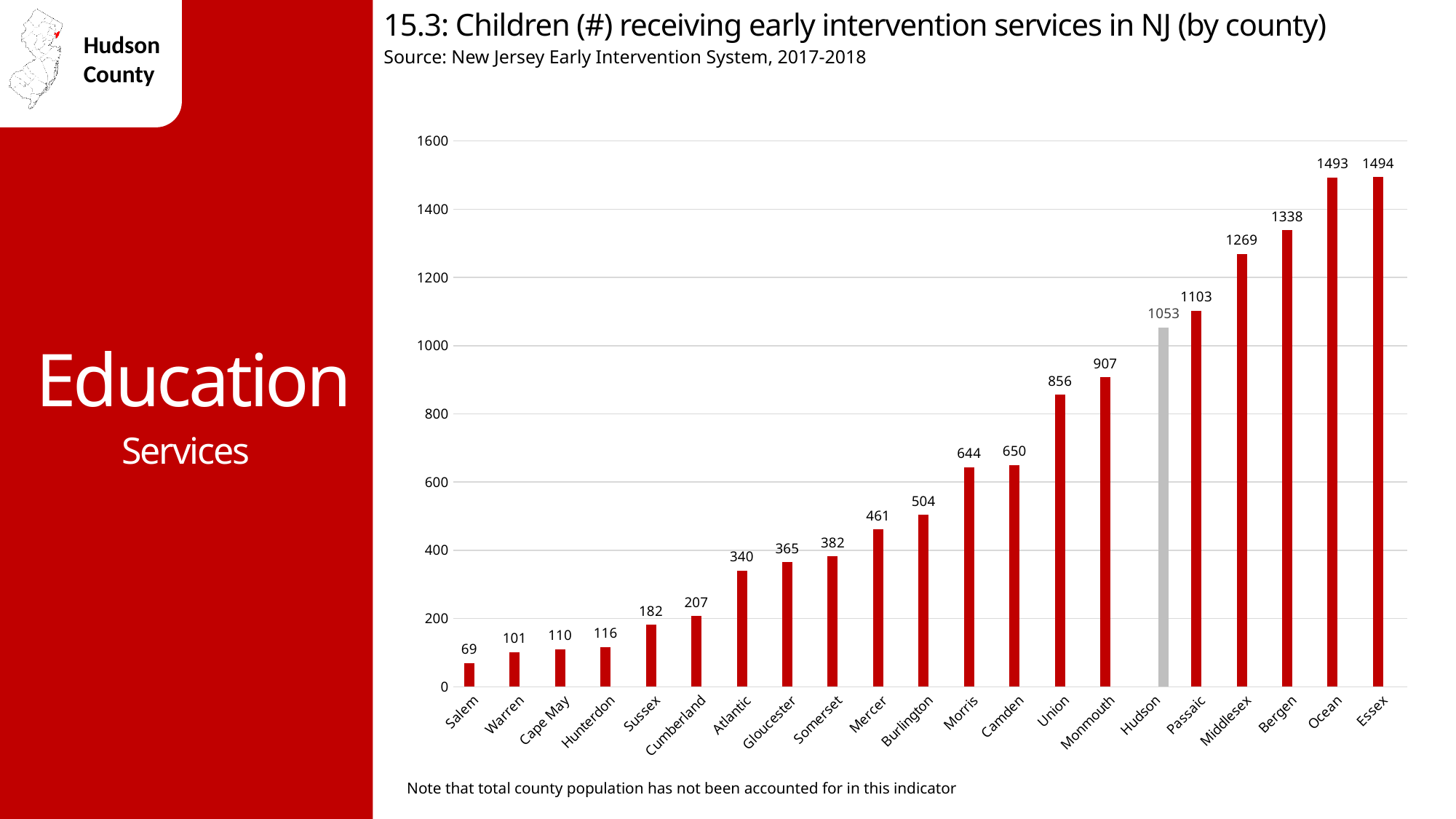
Which county has a higher value, Morris or Mercer? Morris Which county's bar is coloured grey instead of red? Hudson What type of chart is shown on the slide? bar chart What is the value shown for Cumberland? 207 What is the value shown for Bergen? 1338 How many children in Hudson County received early intervention services? 1053 Which county has the lowest number of children receiving early intervention services? Salem Is the value for Middlesex greater or less than 1200? greater Do the values generally rise or fall from left to right along the x axis? rise What is the difference between the values for Passaic and Hudson? 50 How many counties are shown on the chart? 21 What is the difference between the values for Monmouth and Union? 51